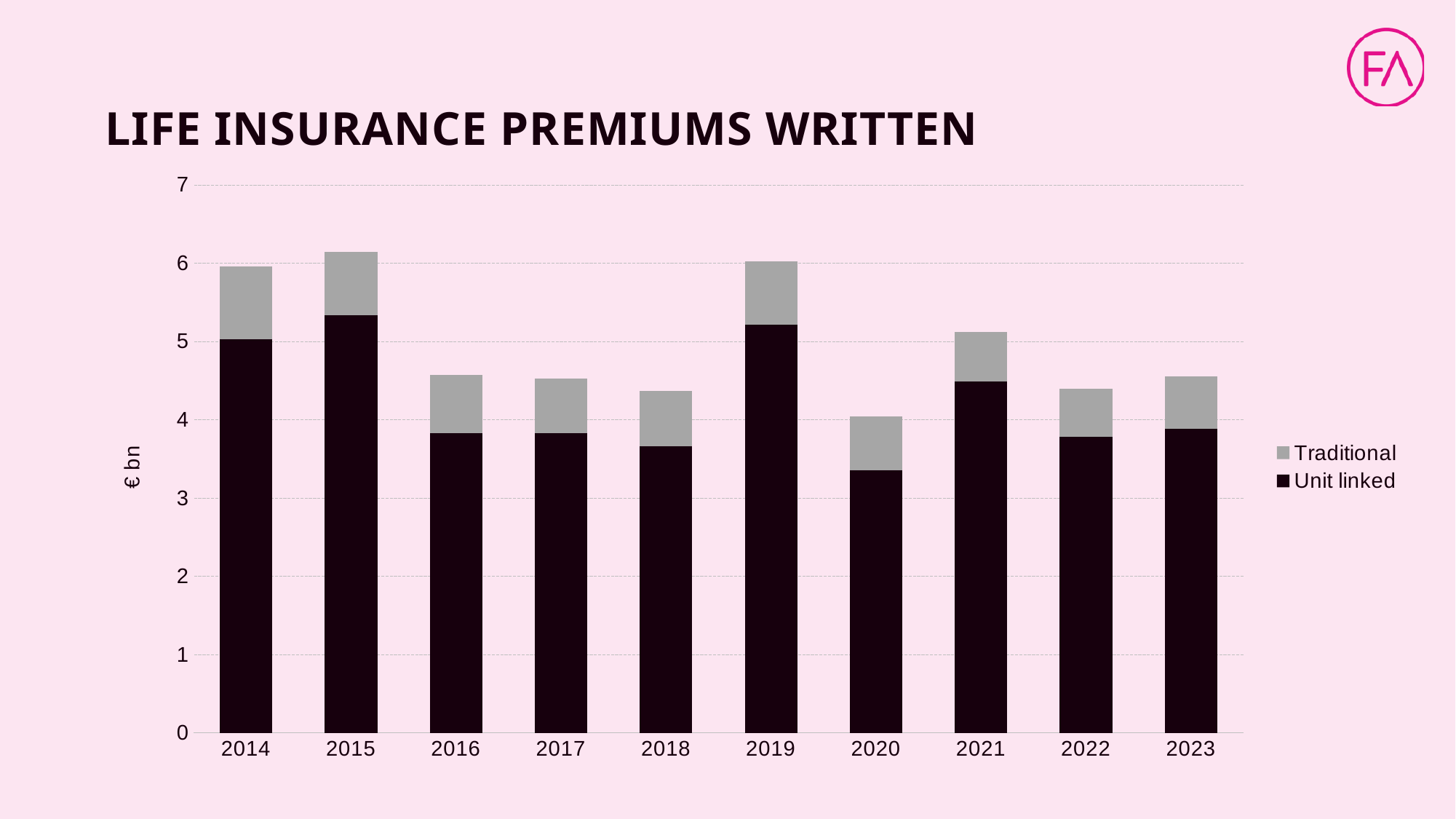
Is the Unit linked value for 2019 greater or less than 5? greater Is the total bar for 2015 greater or less than 6? greater Is the total bar for 2020 greater or less than 5? less How many series does the legend list? 2 Which year has the lowest Unit linked premiums? 2020 Which year has the larger total bar, 2014 or 2020? 2014 Which year has the lowest total life insurance premiums written? 2020 Do total premiums rise or fall from 2019 to 2020? fall How many years are shown on the x axis of the chart? 10 What unit is shown on the y axis label? € bn What kind of chart is shown on the slide? Stacked bar chart